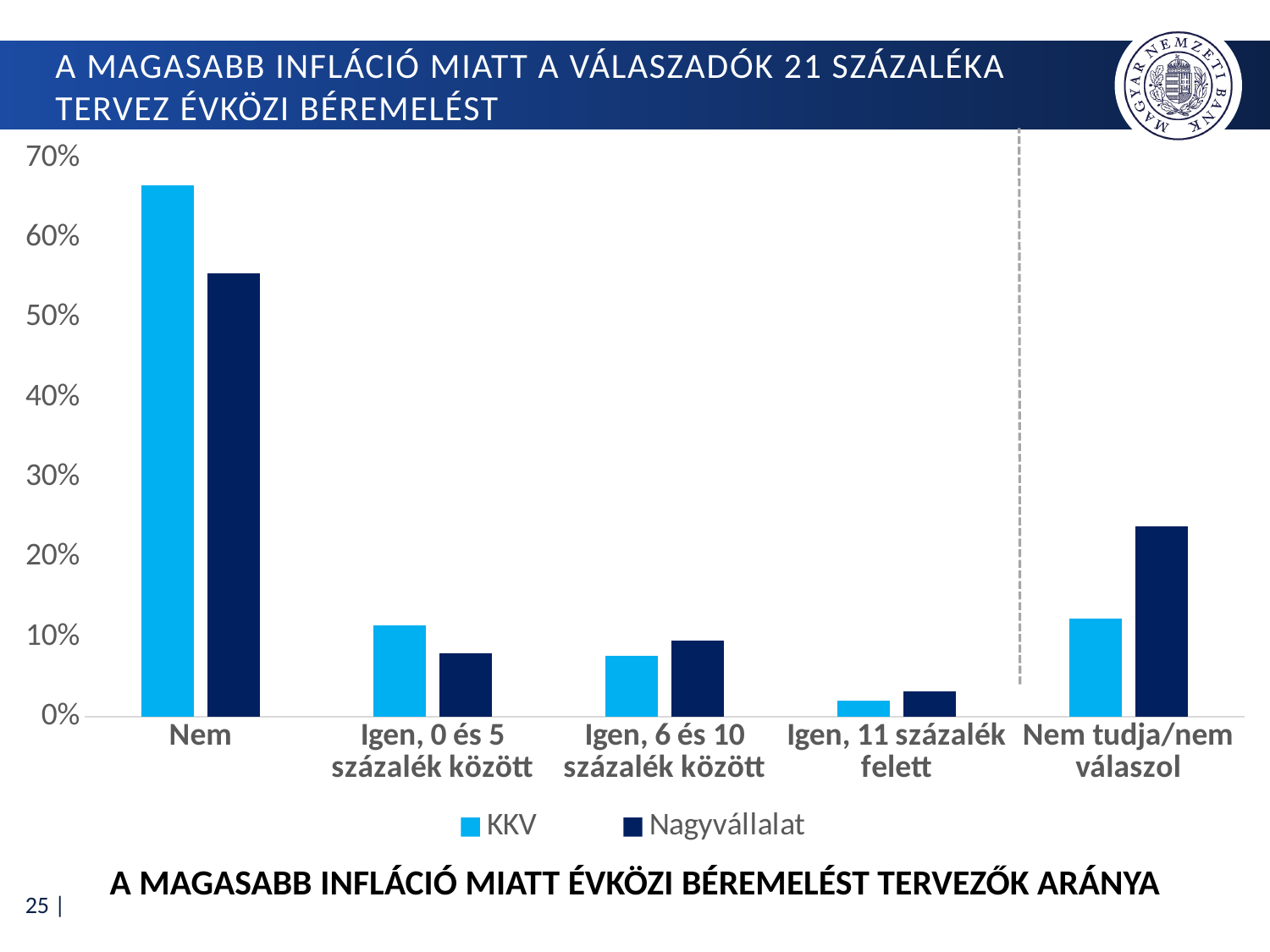
How many series does the legend list? 2 What kind of chart is shown on the slide? bar chart Which category has the highest value for the KKV series? Nem Is the Nagyvállalat value for Nem greater or less than 60%? less What are the two series named in the legend? KKV and Nagyvállalat Is the Nagyvállalat value for Nem tudja/nem válaszol greater or less than 20%? greater Which category has the lowest value for the KKV series? Igen, 11 százalék felett Which category has the lowest value for the Nagyvállalat series? Igen, 11 százalék felett Which category has the highest value for the Nagyvállalat series? Nem For the category Nem tudja/nem válaszol, which series has the larger value, KKV or Nagyvállalat? Nagyvállalat How many categories are shown on the x axis of the chart? 5 Is the KKV value for Nem greater or less than 60%? greater